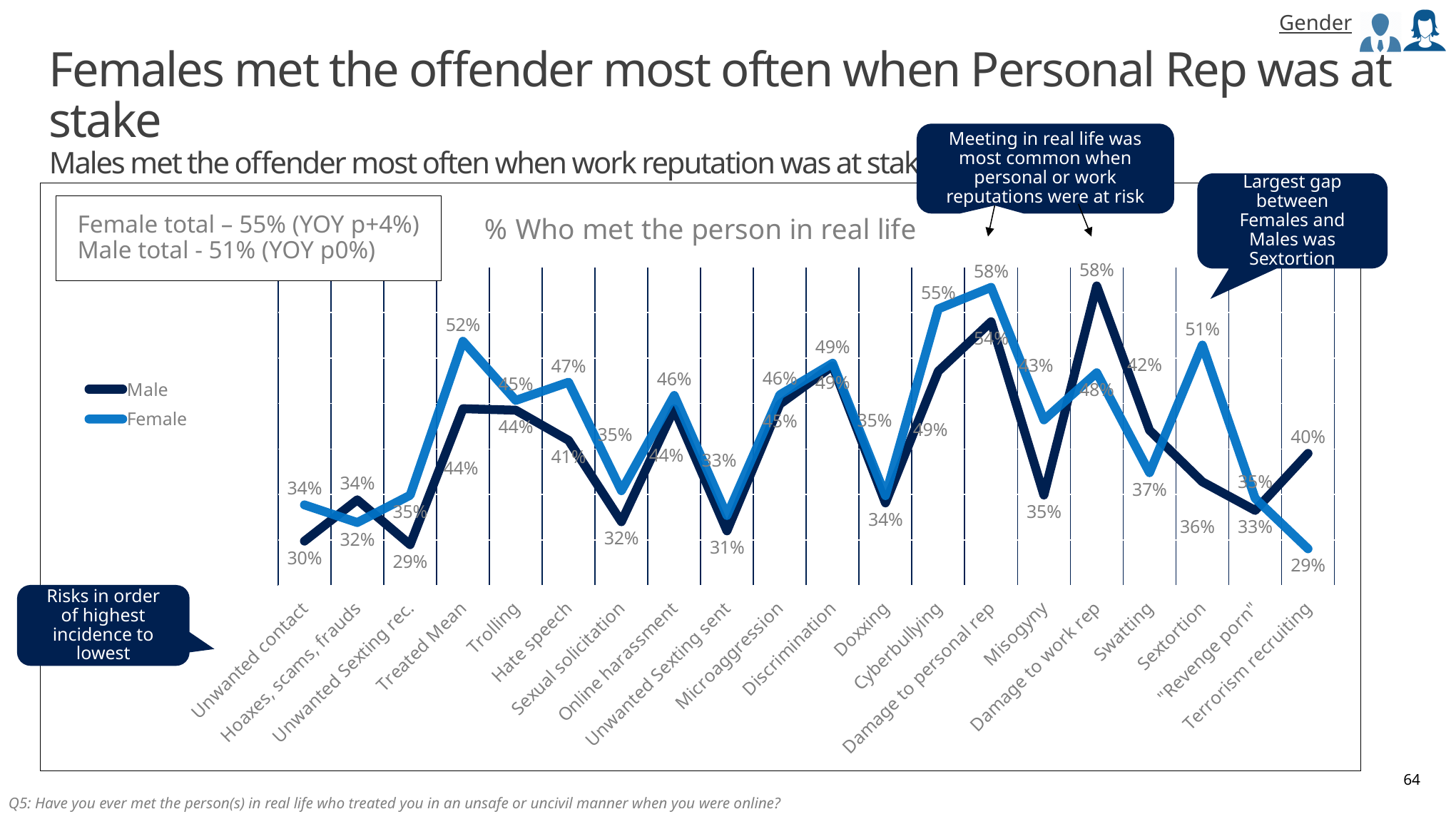
What type of chart is shown on the slide? Line chart How many series does the chart legend list? 2 Which is larger for Misogyny, the Male value or the Female value? Female What is the title of the chart? % Who met the person in real life How many risk categories are plotted along the x axis? 20 What is the difference between the Male and Female values for Terrorism recruiting? 11% What is the Male value for Damage to work rep? 58% For which category is the Male value lowest? Unwanted Sexting rec. For which category is the Female value highest? Damage to personal rep What is the Female value for Terrorism recruiting? 29% What is the Female value for Sextortion? 51% What is the difference between the Female and Male values for Sextortion? 15%